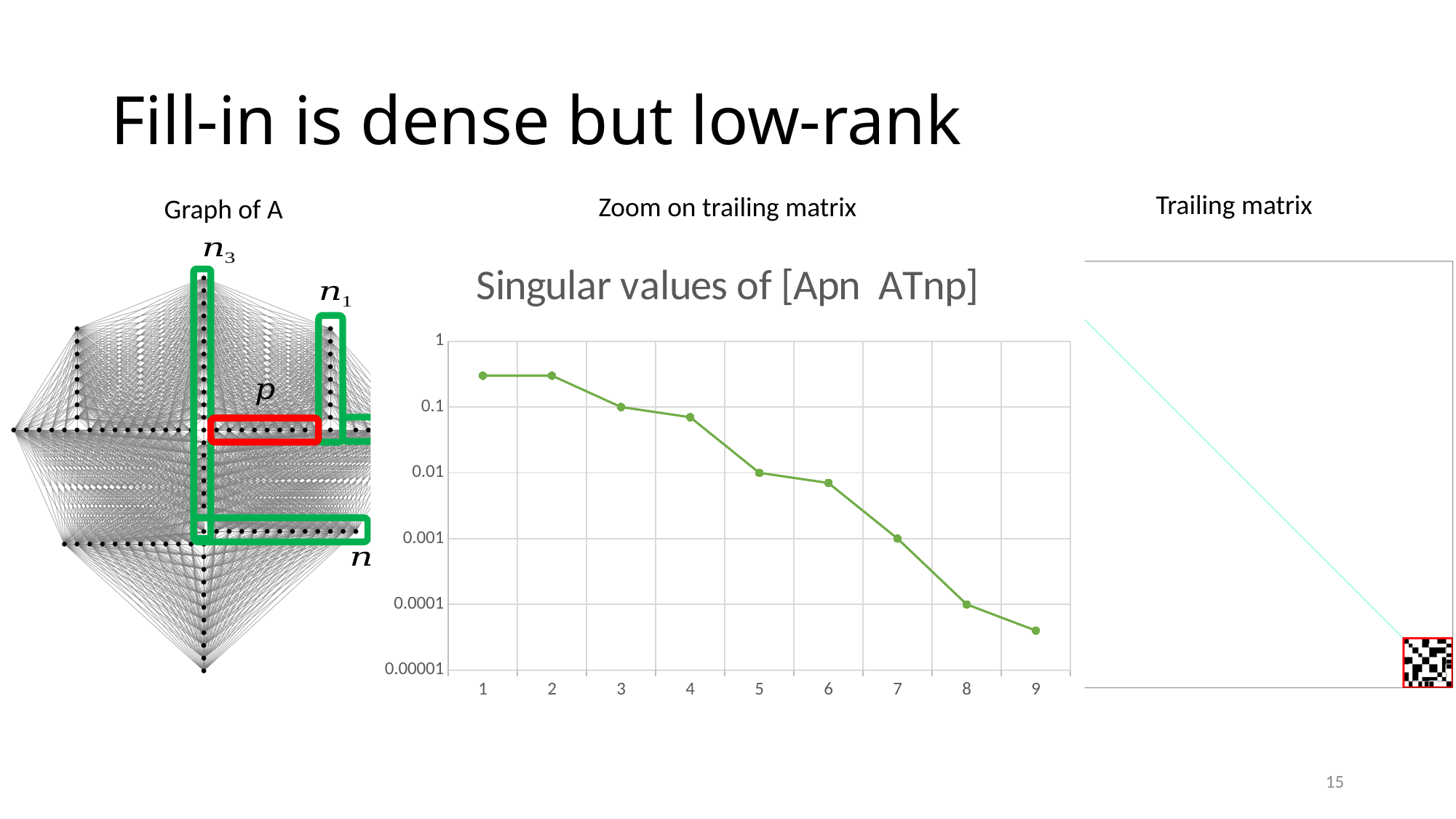
In the "Singular values of [Apn ATnp]" chart, is the value at x = 9 greater or less than 0.0001? less In the "Singular values of [Apn ATnp]" chart, do the values rise or fall as the x axis goes from 1 to 9? fall In the "Singular values of [Apn ATnp]" chart, which is larger, the value at x = 2 or the value at x = 5? x = 2 How many points are plotted in the "Singular values of [Apn ATnp]" chart? 9 In the "Singular values of [Apn ATnp]" chart, is the value at x = 4 greater or less than 0.1? less In the "Singular values of [Apn ATnp]" chart, is the value at x = 1 greater or less than 0.1? greater In the "Singular values of [Apn ATnp]" chart, what is the highest value labelled on the y axis? 1 In the "Singular values of [Apn ATnp]" chart, what is the lowest value labelled on the y axis? 0.00001 In the "Singular values of [Apn ATnp]" chart, which x value has the lowest singular value? 9 What kind of chart is shown under the title "Singular values of [Apn ATnp]"? line chart